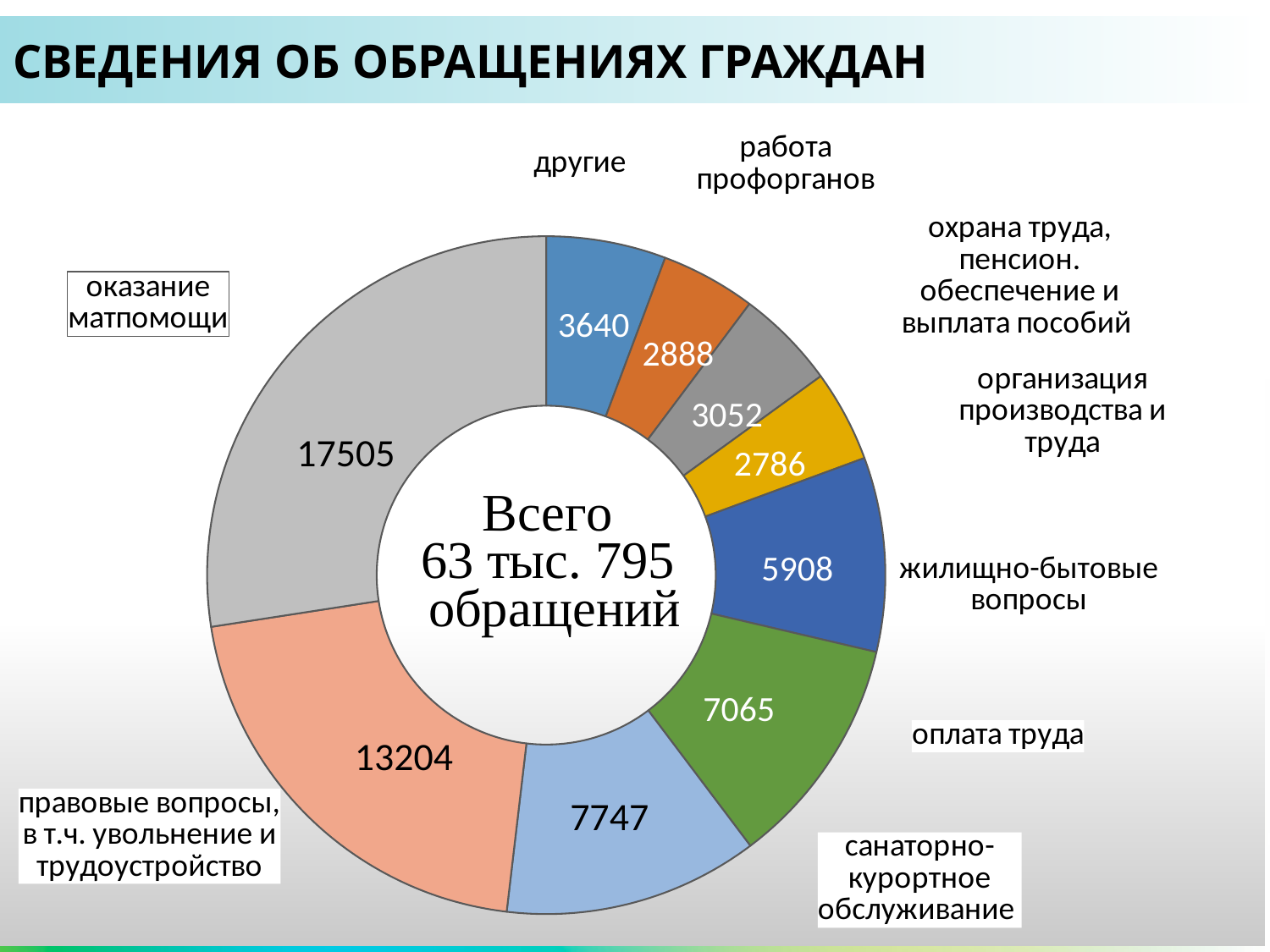
What is the value for «жилищно-бытовые вопросы»? 5908 Which category has the lowest value? организация производства и труда How many segments (categories) does the chart have? 9 What type of chart is shown on the slide? doughnut (pie) chart What is the value for «оказание матпомощи»? 17505 What is the value for «санаторно-курортное обслуживание»? 7747 What is the difference between «оказание матпомощи» and «правовые вопросы»? 4301 What is the title of the slide? СВЕДЕНИЯ ОБ ОБРАЩЕНИЯХ ГРАЖДАН Which category has the highest value? оказание матпомощи What is the value for «правовые вопросы, в т.ч. увольнение и трудоустройство»? 13204 What total number of appeals is stated in the centre of the chart? 63 тыс. 795 обращений Which is larger: «оплата труда» or «санаторно-курортное обслуживание»? санаторно-курортное обслуживание